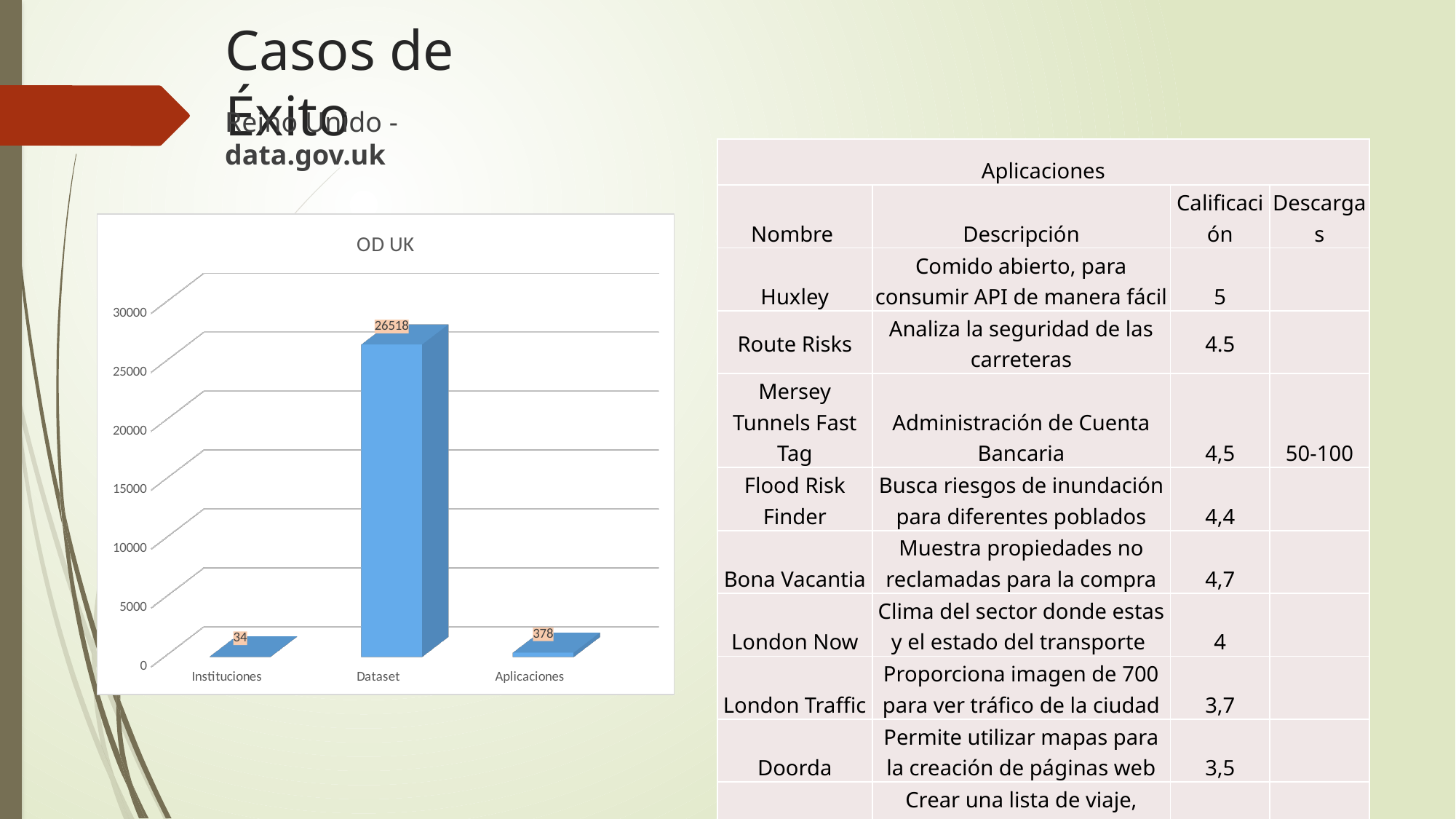
What is the difference between the Dataset and Aplicaciones values in the OD UK chart? 26140 Is the value for Dataset in the OD UK chart greater or less than 25000? greater What is the title of the chart on the slide? OD UK What kind of chart is the OD UK chart? bar chart Which category has the highest value in the OD UK chart? Dataset What is the value for Aplicaciones in the OD UK chart? 378 How many categories are shown in the OD UK chart? 3 What is the value for Dataset in the OD UK chart? 26518 Which category has the lowest value in the OD UK chart? Instituciones What is the difference between the Aplicaciones and Instituciones values in the OD UK chart? 344 What is the value for Instituciones in the OD UK chart? 34 Which is larger in the OD UK chart, Aplicaciones or Instituciones? Aplicaciones